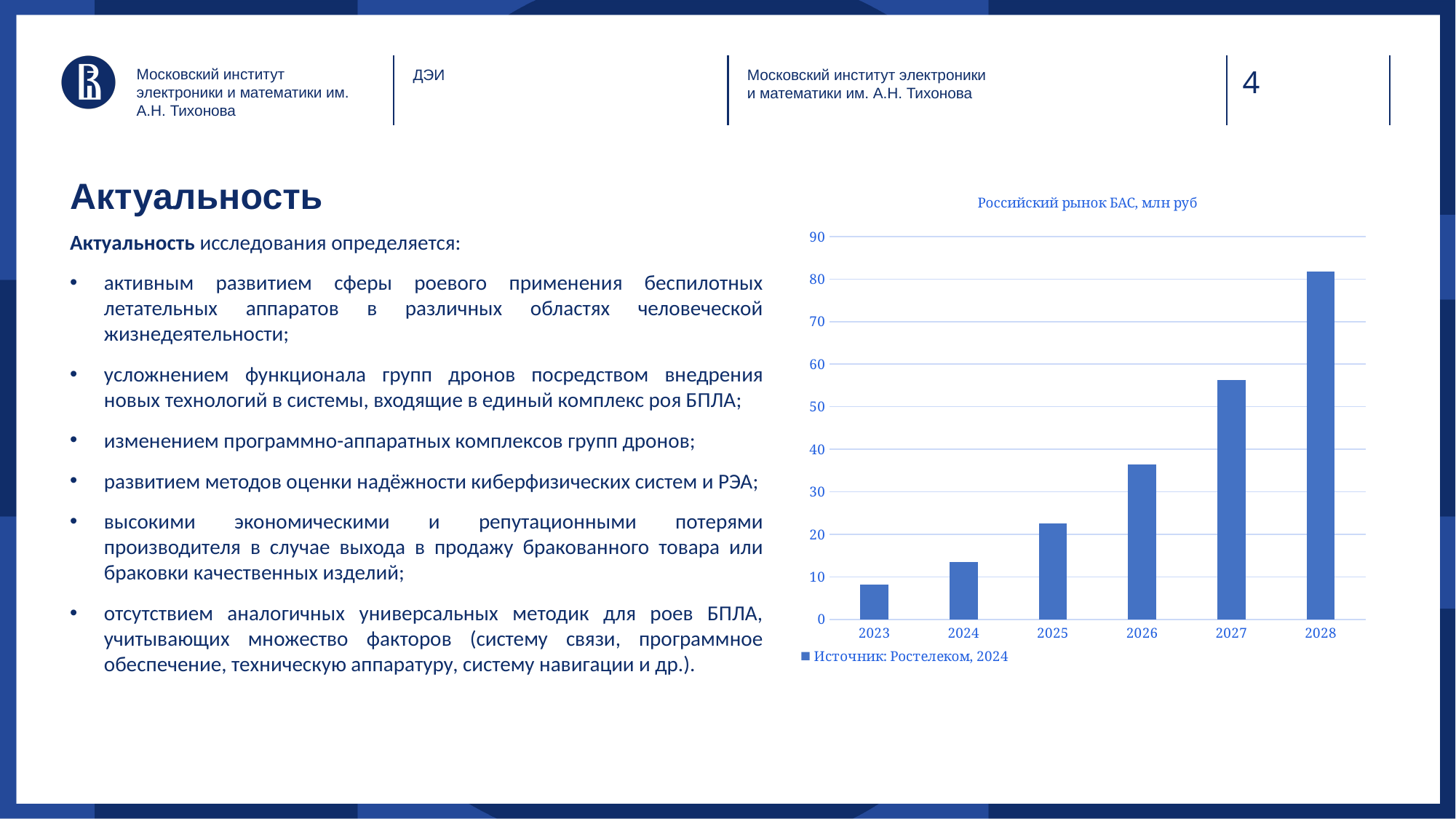
Do the values rise or fall from 2023 to 2028? rise What kind of chart is shown on the slide? bar chart What is the title of the chart? Российский рынок БАС, млн руб Which is larger, the value for 2026 or the value for 2025? 2026 What is the legend entry of the chart? Источник: Ростелеком, 2024 Is the value for 2028 greater or less than 80? greater Which year has the highest value in the chart? 2028 How many series does the chart legend list? 1 Is the value for 2023 greater or less than 10? less How many years (categories) are shown on the x axis of the chart? 6 Which year has the lowest value in the chart? 2023 Is the value for 2027 greater or less than 50? greater